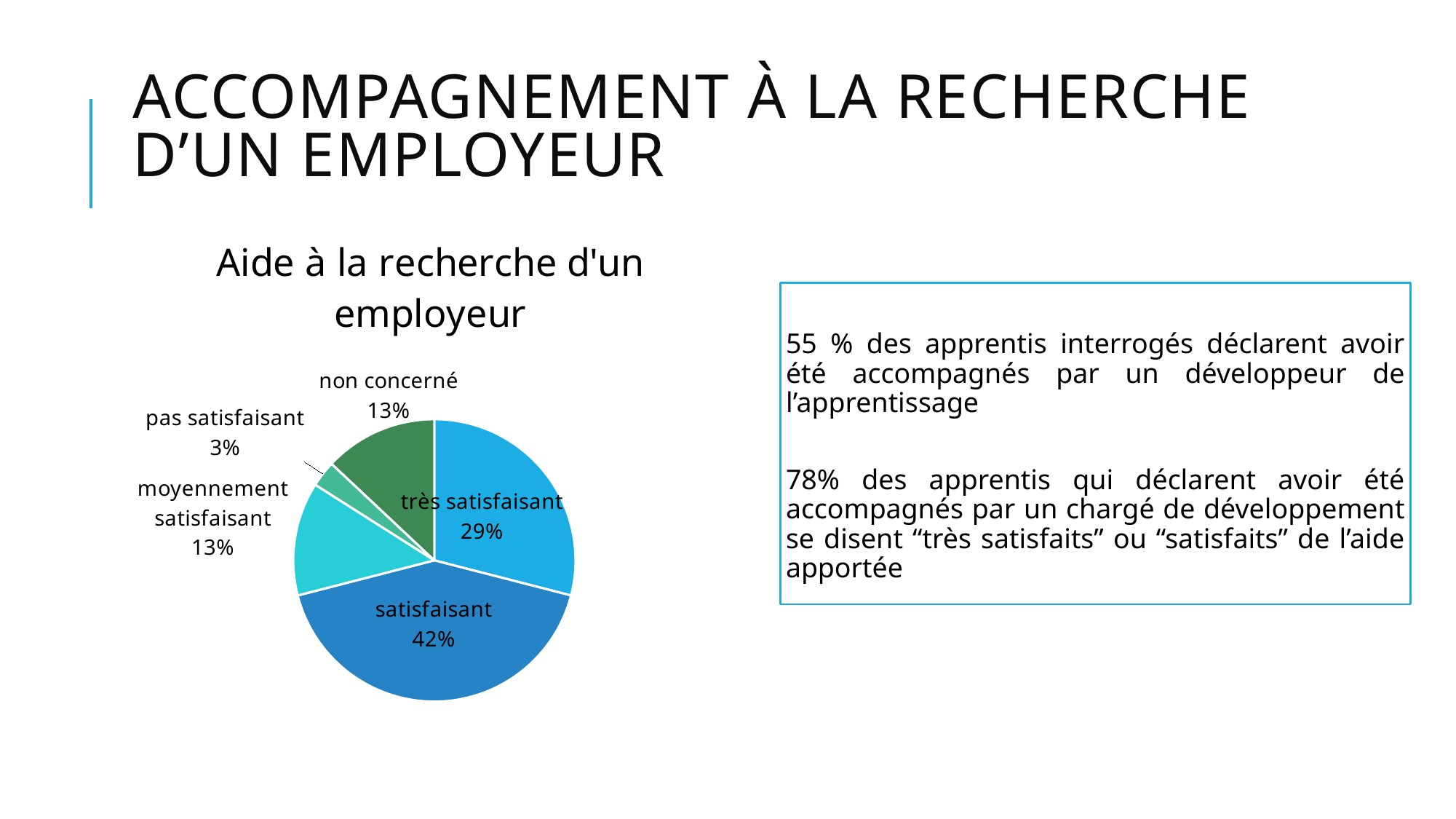
What share of the pie is labelled "satisfaisant"? 42% What is the title of the chart? Aide à la recherche d'un employeur What is the difference between the shares for "satisfaisant" and "très satisfaisant"? 13% Which is larger, the share for "moyennement satisfaisant" or the share for "pas satisfaisant"? moyennement satisfaisant How many categories are shown in the pie chart? 5 Which category has the smallest slice of the pie? pas satisfaisant What kind of chart is shown on the slide? pie chart What share of the pie is labelled "très satisfaisant"? 29% What is the combined share of "très satisfaisant" and "satisfaisant"? 71% What share of the pie is labelled "pas satisfaisant"? 3% Which category has the largest slice of the pie? satisfaisant